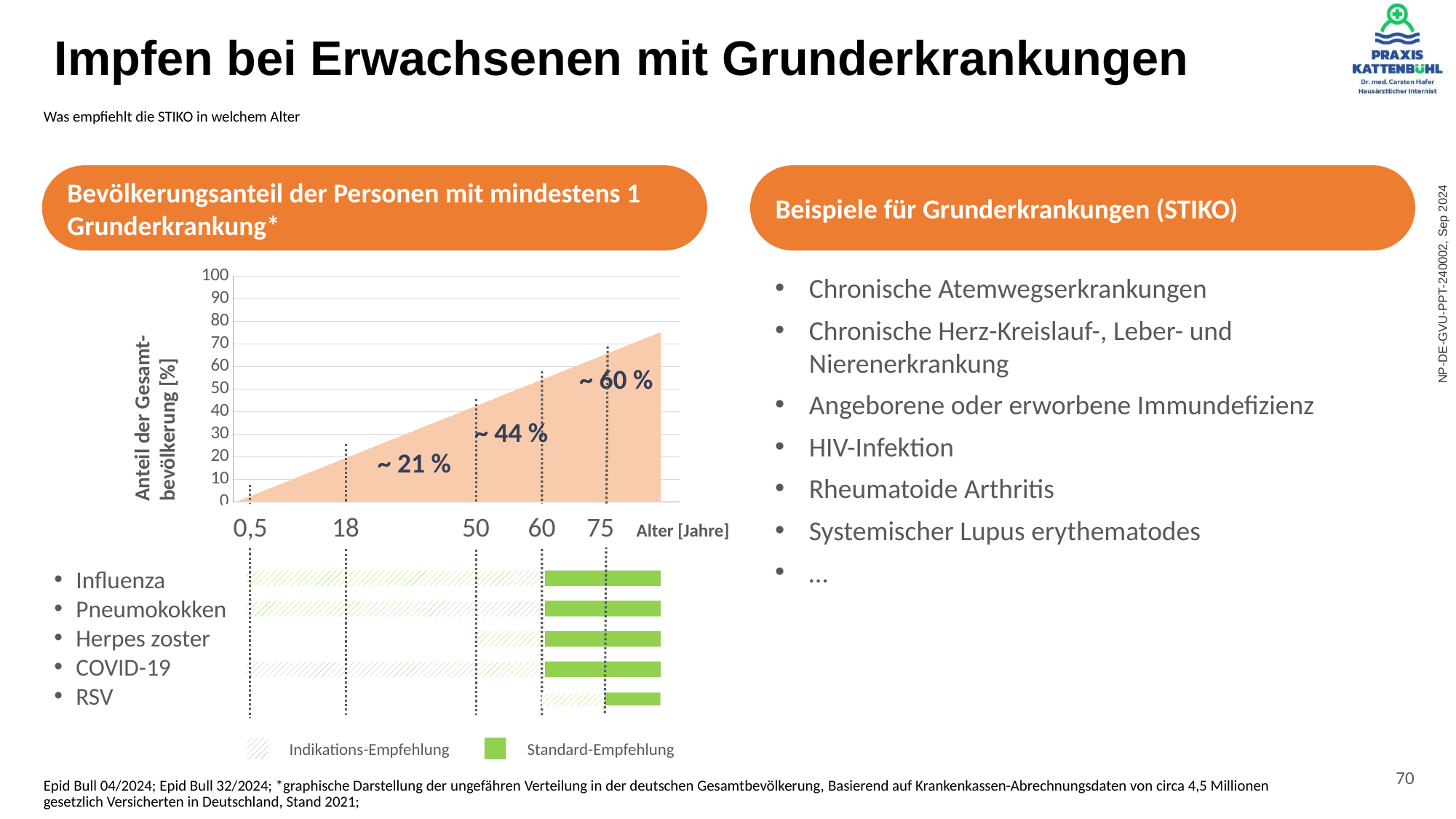
In the chart 'Bevölkerungsanteil der Personen mit mindestens 1 Grunderkrankung', which is larger: the share at age 18 or the share at age 60? age 60 What is the label of the y axis of the chart 'Bevölkerungsanteil der Personen mit mindestens 1 Grunderkrankung'? Anteil der Gesamtbevölkerung [%] In the chart 'Bevölkerungsanteil der Personen mit mindestens 1 Grunderkrankung', is the value at age 75 greater or less than 50? greater How many age values are labelled on the x axis of the chart 'Bevölkerungsanteil der Personen mit mindestens 1 Grunderkrankung'? 5 How many entries does the legend below the vaccination chart list? 2 In the chart 'Bevölkerungsanteil der Personen mit mindestens 1 Grunderkrankung', is the value at age 18 greater or less than 30? less In the chart 'Bevölkerungsanteil der Personen mit mindestens 1 Grunderkrankung', is the value at age 50 greater or less than 40? greater How many vaccines are listed in the recommendation chart below the age axis? 5 What kind of chart shows the share of the population with at least one underlying disease by age? area chart In the chart 'Bevölkerungsanteil der Personen mit mindestens 1 Grunderkrankung', at which labelled age is the share of the population lowest? 0,5 In the chart 'Bevölkerungsanteil der Personen mit mindestens 1 Grunderkrankung', at which labelled age is the share of the population highest? 75 In the chart 'Bevölkerungsanteil der Personen mit mindestens 1 Grunderkrankung', does the share of the population rise or fall as age increases? rises